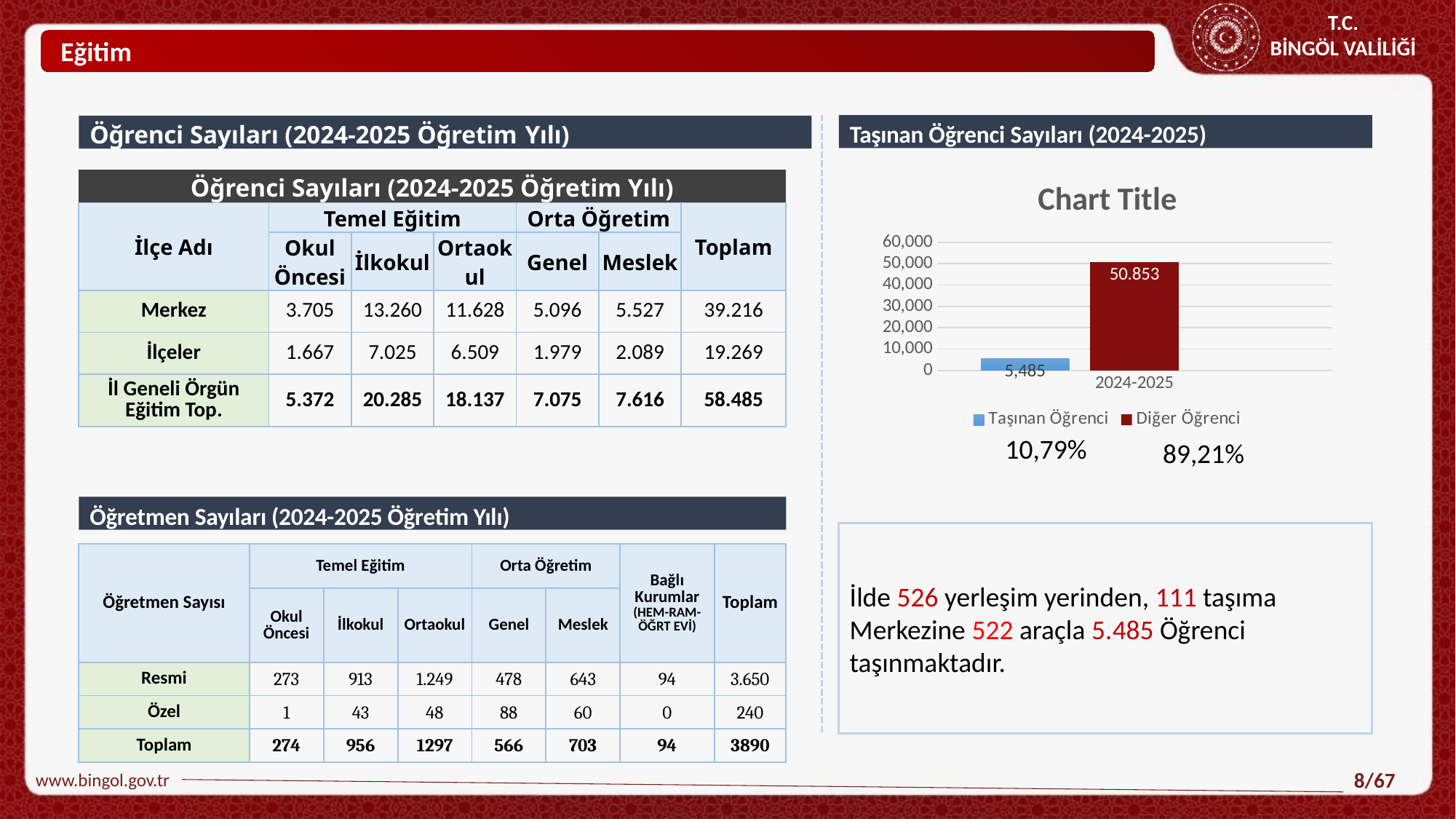
What is the title printed above the bar chart? Chart Title Is the value for Taşınan Öğrenci greater or less than 10,000? less Which series has the highest value in the bar chart? Diğer Öğrenci What colour is the Diğer Öğrenci bar in the chart? dark red Is the value for Diğer Öğrenci greater or less than 40,000? greater What is the value for Taşınan Öğrenci in the bar chart? 5,485 What is the value for Diğer Öğrenci in the bar chart? 50.853 How many categories are shown on the x axis of the bar chart? 1 How many series does the legend of the bar chart list? 2 What kind of chart is shown on the right side of the slide? bar chart Which is larger in the bar chart, Taşınan Öğrenci or Diğer Öğrenci? Diğer Öğrenci Which series has the lowest value in the bar chart? Taşınan Öğrenci